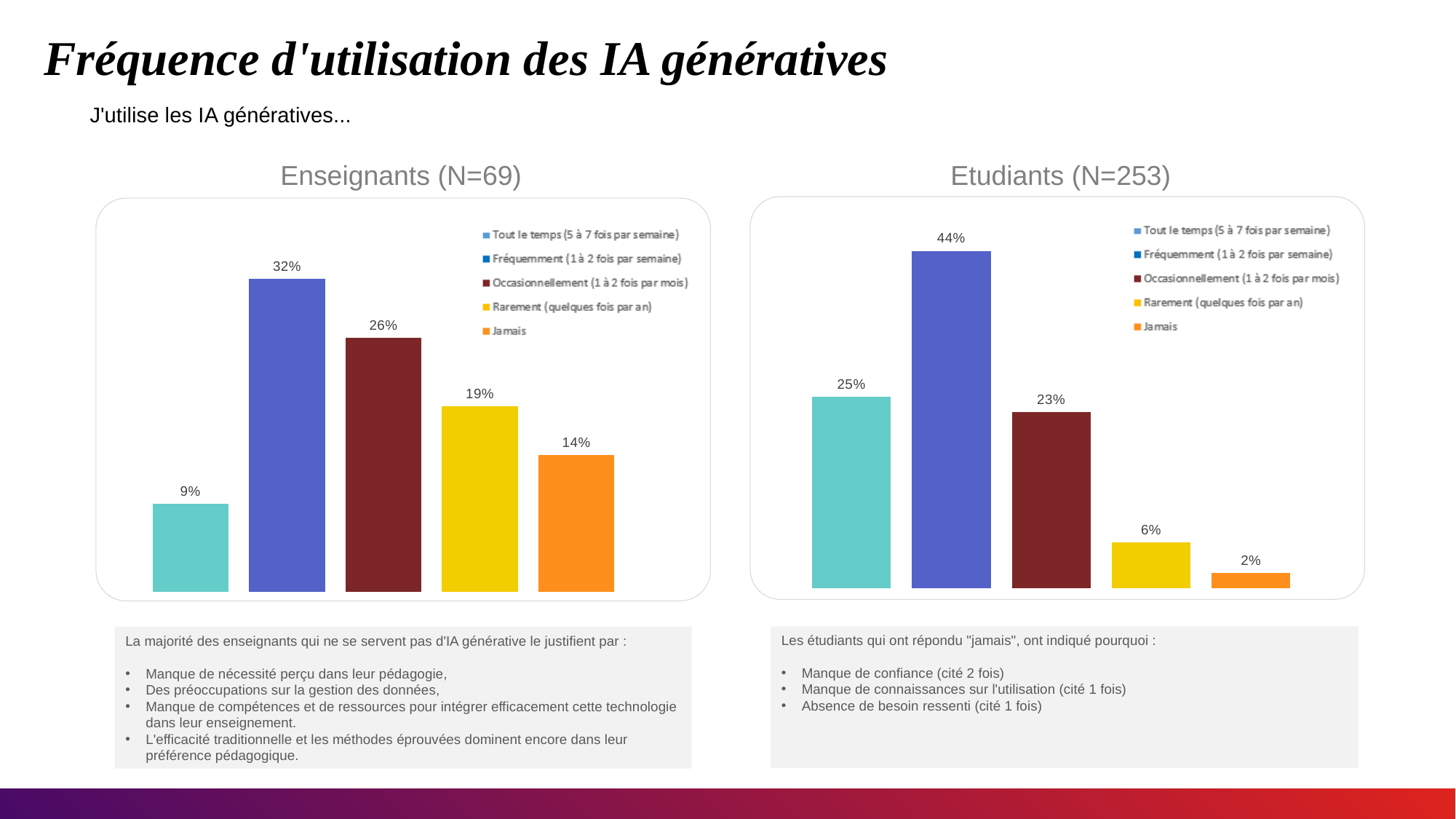
In the Enseignants (N=69) chart, what is the value for Fréquemment (1 à 2 fois par semaine)? 32% In the Etudiants (N=253) chart, what is the value for Jamais? 2% In the Etudiants (N=253) chart, which category has the highest value? Fréquemment (1 à 2 fois par semaine) In the Enseignants (N=69) chart, what is the difference between Fréquemment and Occasionnellement? 6% How many bars are in the Enseignants (N=69) chart? 5 How many entries does the legend of the Etudiants (N=253) chart list? 5 In the Enseignants (N=69) chart, which category has the lowest value? Tout le temps (5 à 7 fois par semaine) In the Etudiants (N=253) chart, which is larger: Tout le temps or Occasionnellement? Tout le temps Which is larger: Jamais for Enseignants (N=69) or Jamais for Etudiants (N=253)? Enseignants (N=69) What type of chart is the Etudiants (N=253) chart? Bar chart In the Enseignants (N=69) chart, what is the value for Rarement (quelques fois par an)? 19% In the Etudiants (N=253) chart, what is the difference between Tout le temps and Rarement? 19%